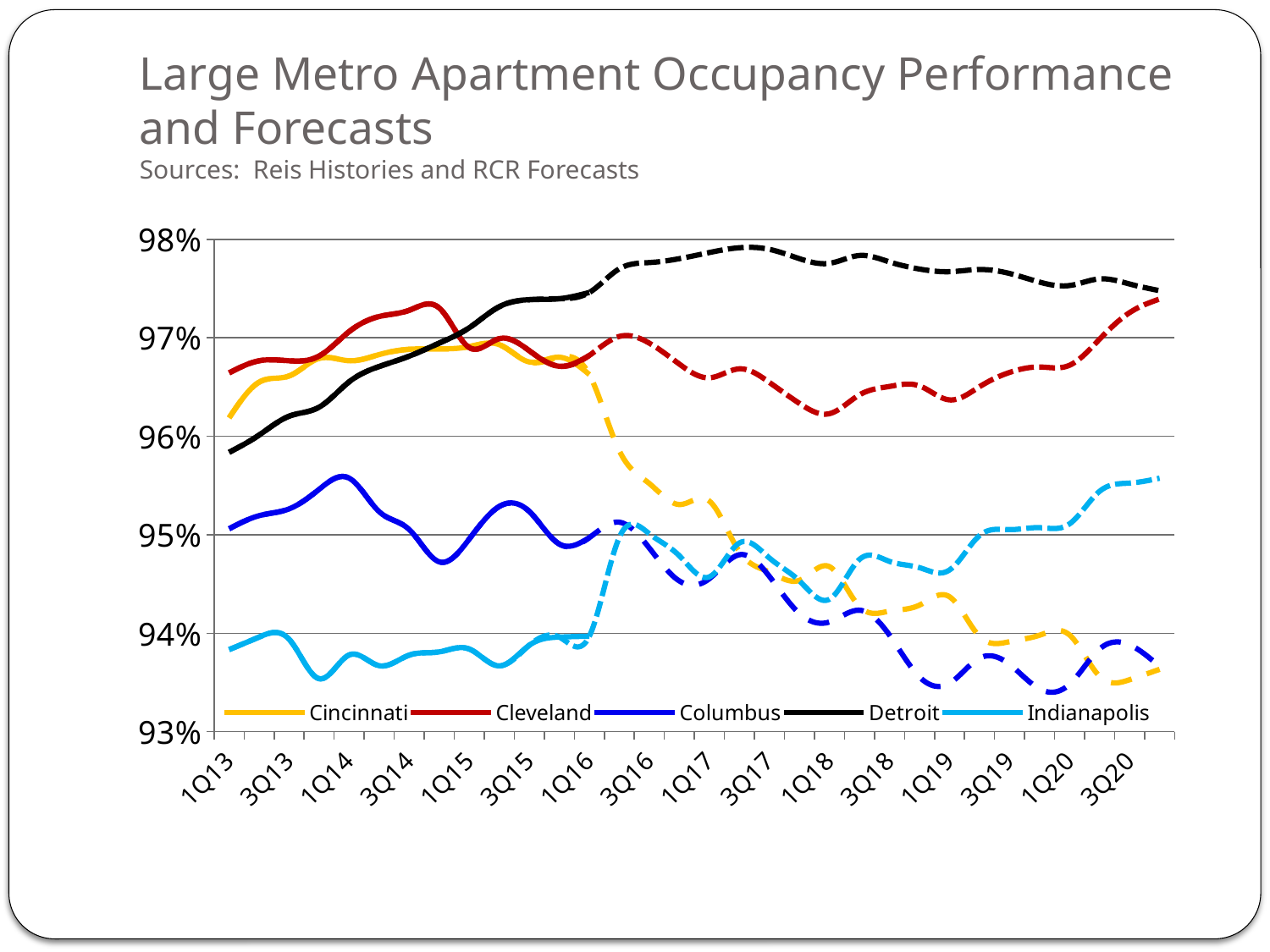
At 3Q17, which is higher: Detroit or Cleveland? Detroit Which series has the lowest value at 1Q13? Indianapolis Which metro areas are listed in the chart legend? Cincinnati, Cleveland, Columbus, Detroit, Indianapolis Is the value for Columbus at 1Q14 greater or less than 95%? greater Which series has the highest value at 3Q20? Detroit Is the value for Detroit at 3Q17 greater or less than 97%? greater What sources are cited for the chart? Reis Histories and RCR Forecasts Does the Cincinnati line rise or fall from 1Q16 to 3Q20? fall What kind of chart is shown on the slide? line chart Is the value for Indianapolis at 1Q13 greater or less than 94%? less How many series does the legend list? 5